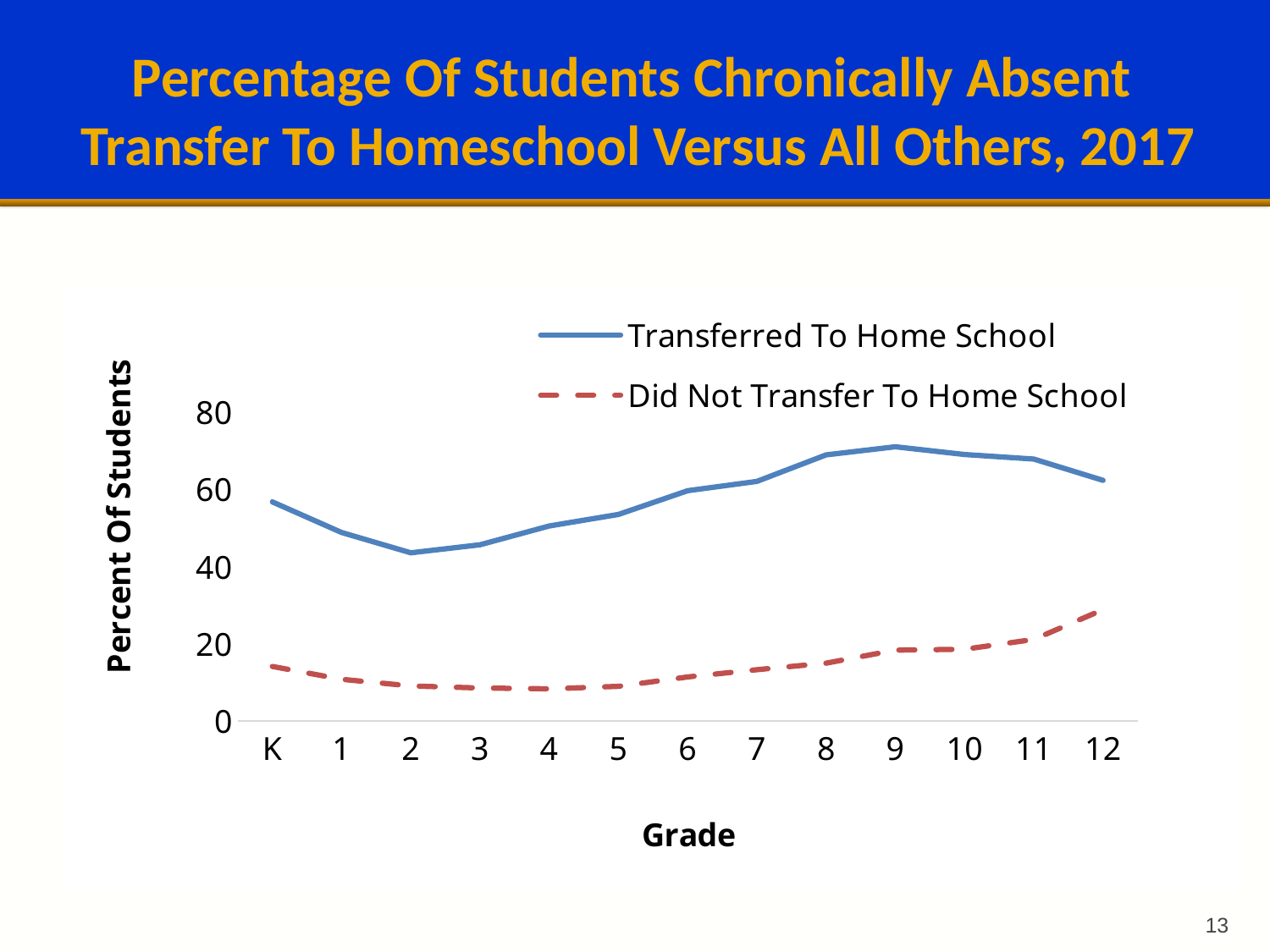
Is the value for Transferred To Home School at grade 2 greater or less than 60? less Which grade has the lowest value for Transferred To Home School? 2 Does the Did Not Transfer To Home School line rise or fall from grade 4 to grade 12? rise How many series does the legend list? 2 At grade 8, which series has the higher value, Transferred To Home School or Did Not Transfer To Home School? Transferred To Home School Which grade has the highest value for Did Not Transfer To Home School? 12 Is the value for Did Not Transfer To Home School at grade 12 greater or less than 20? greater What is the title of the vertical axis? Percent Of Students Is the value for Transferred To Home School at grade 9 greater or less than 60? greater How many grade categories are plotted along the x axis? 13 Which grade has the highest value for Transferred To Home School? 9 What kind of chart is shown on the slide? line chart